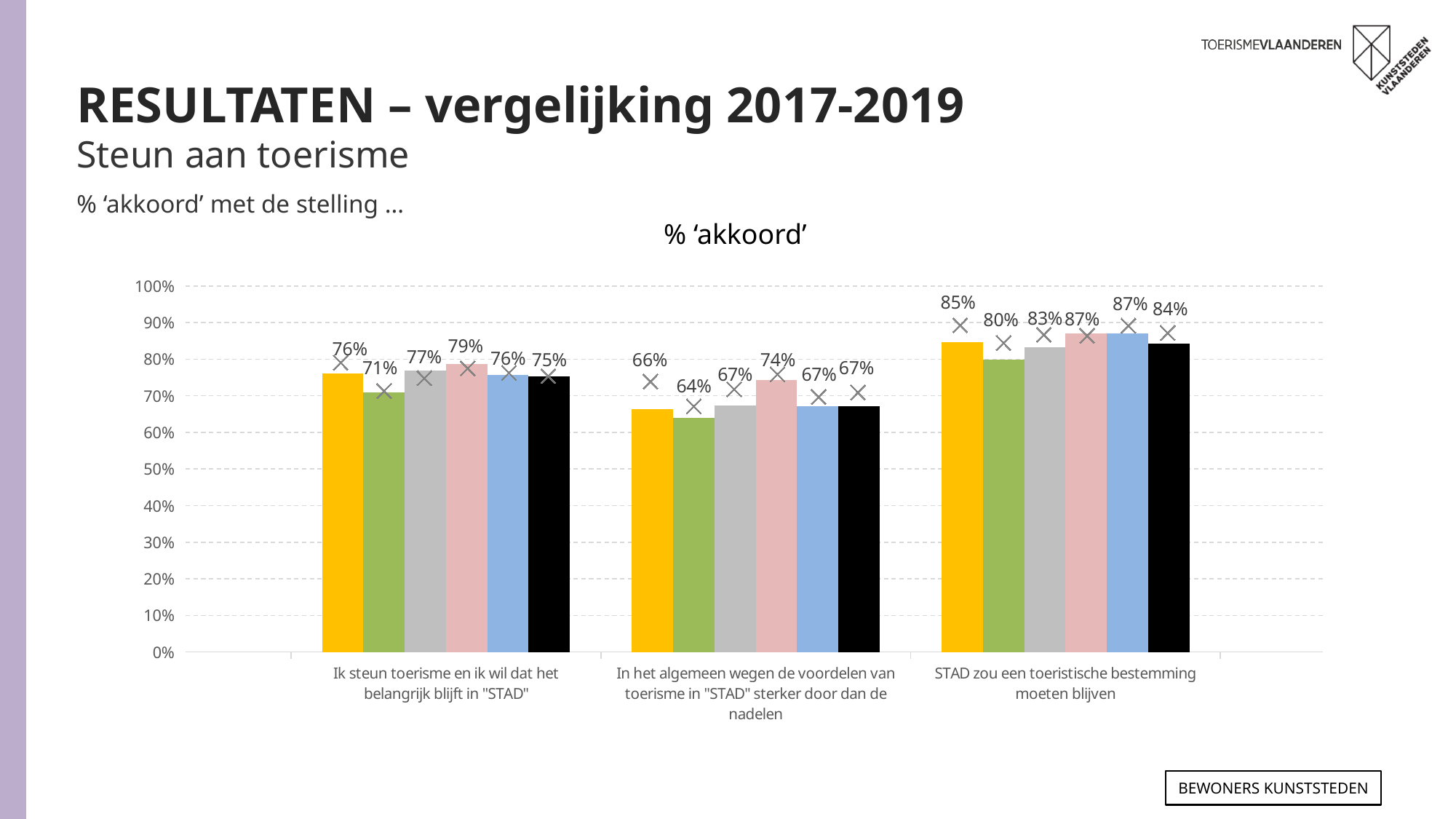
What is the value of the black bar for the statement 'STAD zou een toeristische bestemming moeten blijven'? 84% For the statement 'STAD zou een toeristische bestemming moeten blijven', which is larger: the yellow bar or the green bar? yellow bar (85%) What is the value of the green bar for the statement 'In het algemeen wegen de voordelen van toerisme in "STAD" sterker door dan de nadelen'? 64% What is the value of the yellow bar for the statement 'Ik steun toerisme en ik wil dat het belangrijk blijft in "STAD"'? 76% Which coloured bar has the lowest value for the statement 'In het algemeen wegen de voordelen van toerisme in "STAD" sterker door dan de nadelen'? green (64%) What is the title of the chart? % ‘akkoord’ What is the value of the pink bar for the statement 'STAD zou een toeristische bestemming moeten blijven'? 87% What kind of chart is shown on the slide? bar chart How many statement categories are shown along the x axis of the chart? 3 What is the difference between the pink bar (74%) and the green bar (64%) for the statement 'In het algemeen wegen de voordelen van toerisme in "STAD" sterker door dan de nadelen'? 10 percentage points Which coloured bar has the highest value for the statement 'Ik steun toerisme en ik wil dat het belangrijk blijft in "STAD"'? pink (79%) Is the value of the yellow bar for the statement 'In het algemeen wegen de voordelen van toerisme in "STAD" sterker door dan de nadelen' greater or less than 70%? less